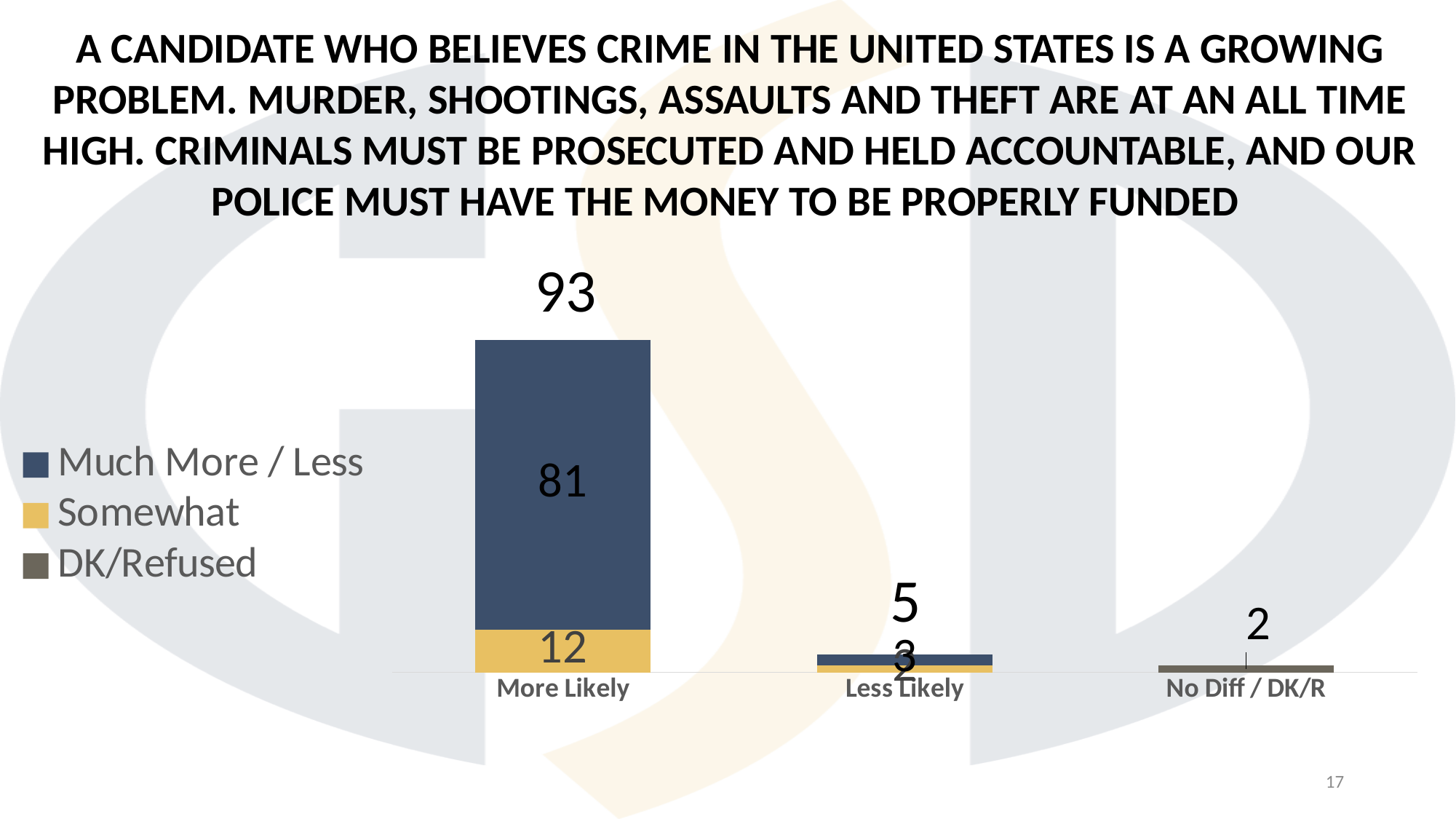
Which category has the lowest total? No Diff / DK/R How many categories are shown on the x axis? 3 What is the value shown for No Diff / DK/R? 2 Which category has the highest total? More Likely How many series does the legend list? 3 What is the total of the stacked bar for More Likely? 93 What is the difference between the totals for More Likely and Less Likely? 88 What is the total of the stacked bar for Less Likely? 5 What is the value of the Somewhat segment for More Likely? 12 Within the More Likely bar, what is the difference between the Much More / Less segment and the Somewhat segment? 69 What kind of chart is shown on the slide? Stacked bar chart What is the value of the Much More / Less segment for More Likely? 81